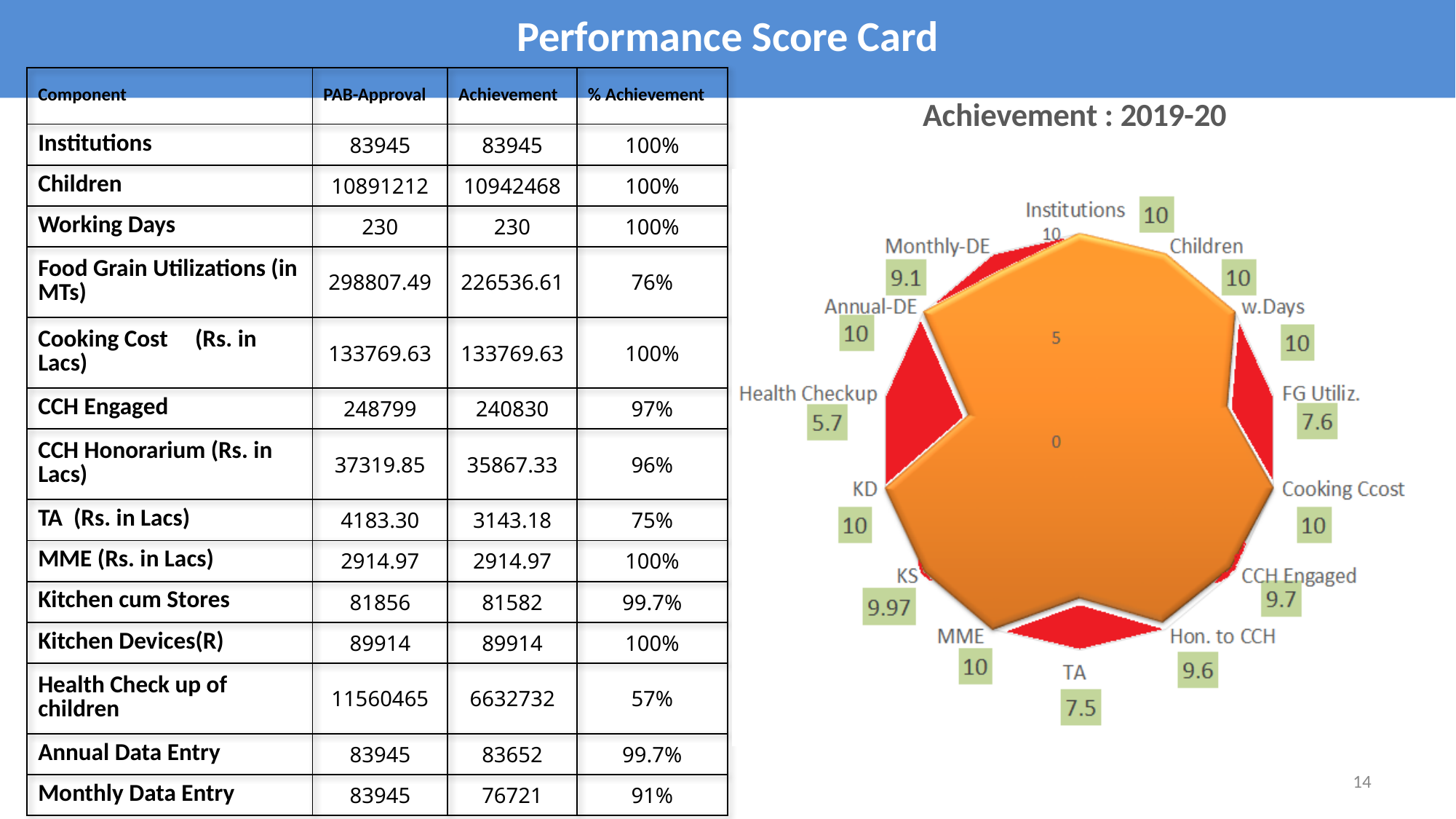
In the radar chart, what is the value for FG Utiliz.? 7.6 What is the title of the radar chart? Achievement : 2019-20 In the radar chart, what is the value for Monthly-DE? 9.1 In the radar chart, what is the difference between the values for Institutions and Health Checkup? 4.3 How many categories are plotted on the radar chart? 14 In the radar chart, which category has the lowest value? Health Checkup What type of chart is shown under the title "Achievement : 2019-20"? radar chart In the radar chart, what is the difference between the values for FG Utiliz. and TA? 0.1 In the radar chart, what is the value for TA? 7.5 In the radar chart, what is the value for Health Checkup? 5.7 In the radar chart, what is the value for KS? 9.97 In the radar chart, which is larger, the value for CCH Engaged or the value for Hon. to CCH? CCH Engaged